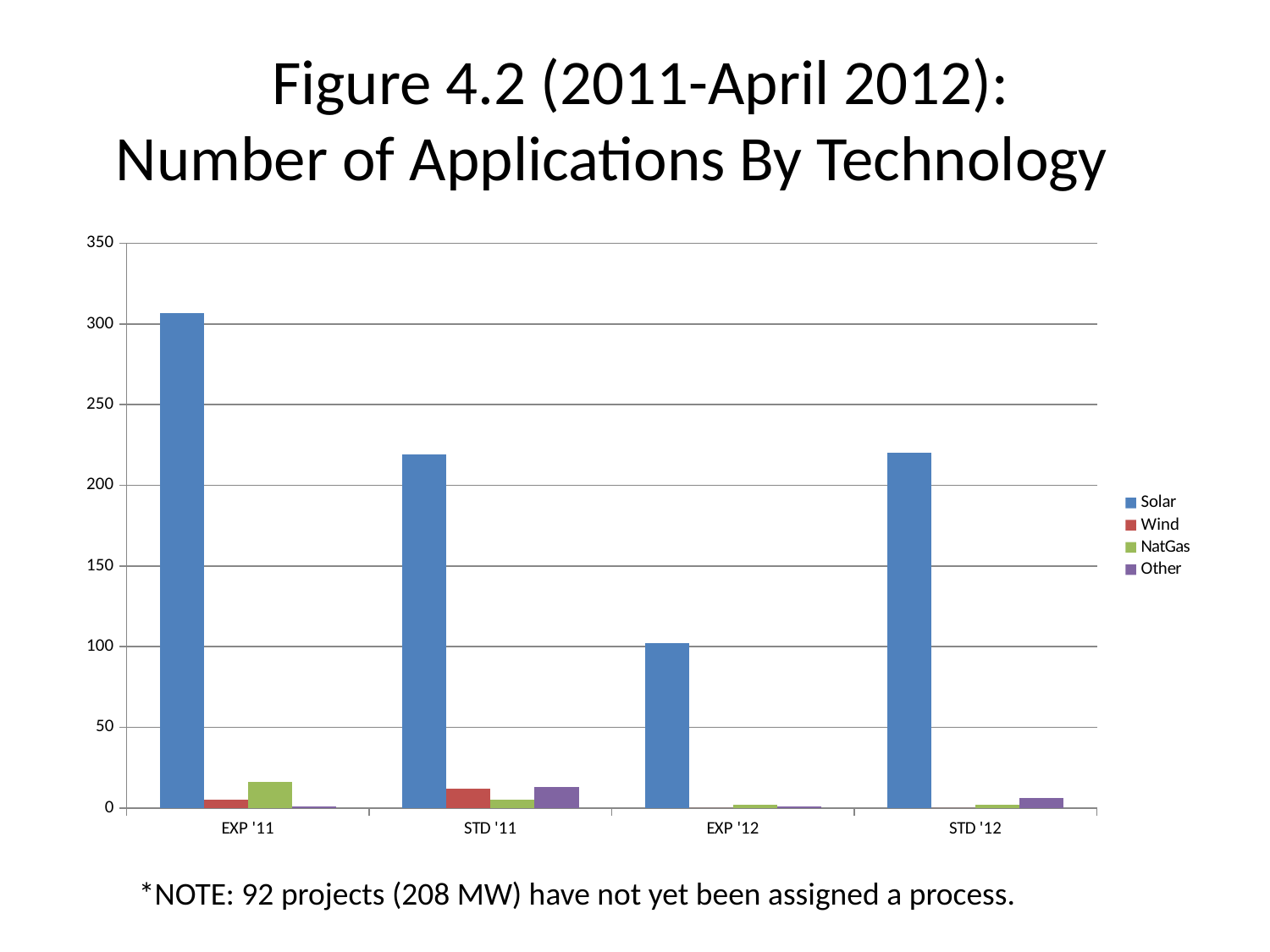
Is the Solar value for STD '11 greater or less than 200? greater How many series does the legend list? 4 Which is larger, the Solar value for EXP '11 or the Solar value for EXP '12? EXP '11 Is the Solar value for STD '12 greater or less than 250? less Which series is shown in blue in the legend? Solar Is the Solar value for EXP '11 greater or less than 300? greater What kind of chart is shown on the slide? bar chart What is the title of the chart? Figure 4.2 (2011-April 2012): Number of Applications By Technology Which category has the highest Solar value? EXP '11 How many categories are shown on the x axis? 4 Which category has the lowest Solar value? EXP '12